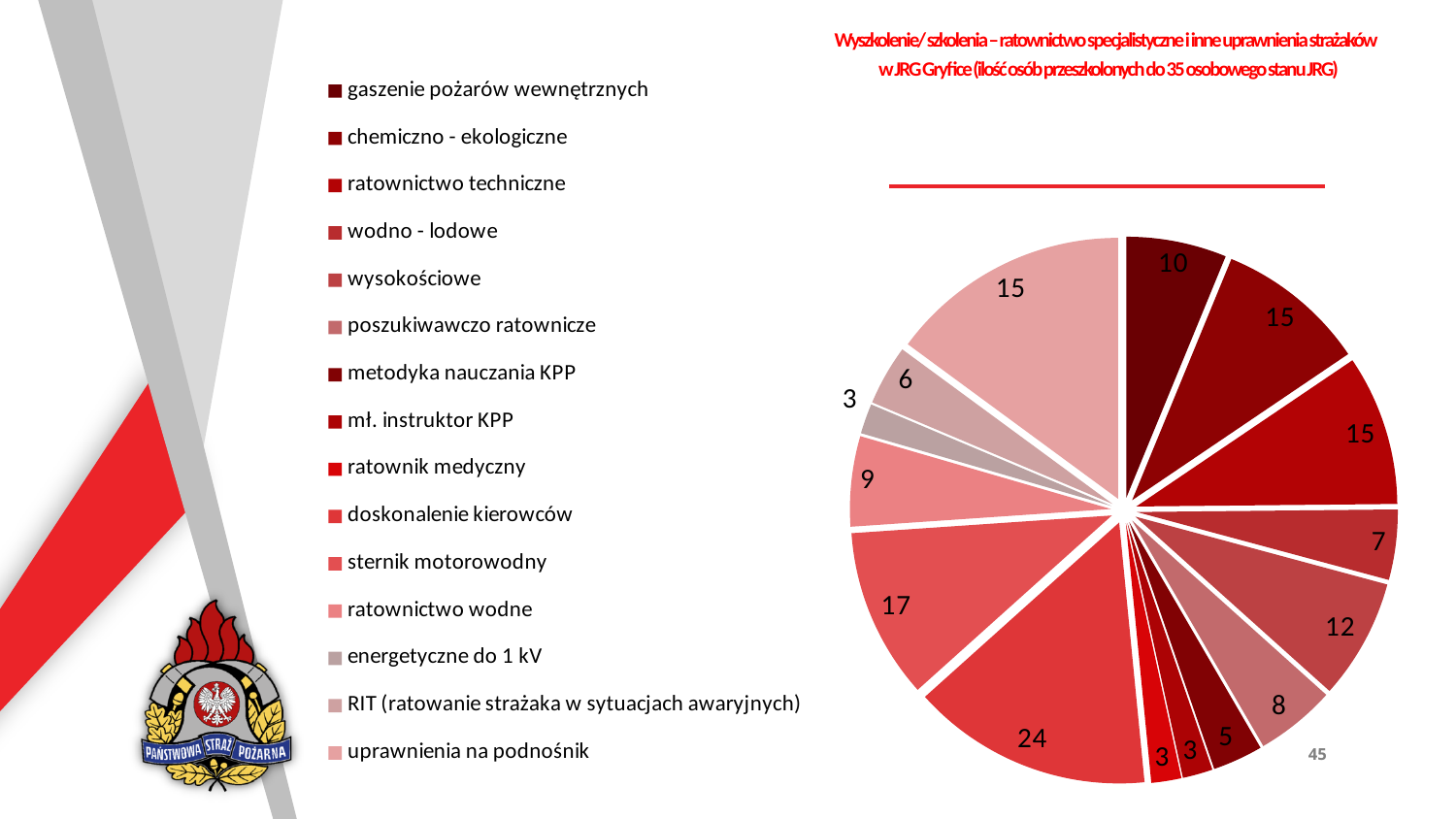
How many categories does the pie chart have? 15 What is the difference between the values for doskonalenie kierowców and sternik motorowodny? 7 What is the first entry listed in the legend? gaszenie pożarów wewnętrznych What kind of chart is shown on the slide? pie chart What is the value for sternik motorowodny? 17 What is the value for ratownictwo wodne? 9 What is the value for doskonalenie kierowców? 24 What is the smallest value shown on any slice of the pie chart? 3 Which is larger, the value for sternik motorowodny or the value for wysokościowe? sternik motorowodny What is the value for gaszenie pożarów wewnętrznych? 10 What is the value for wysokościowe? 12